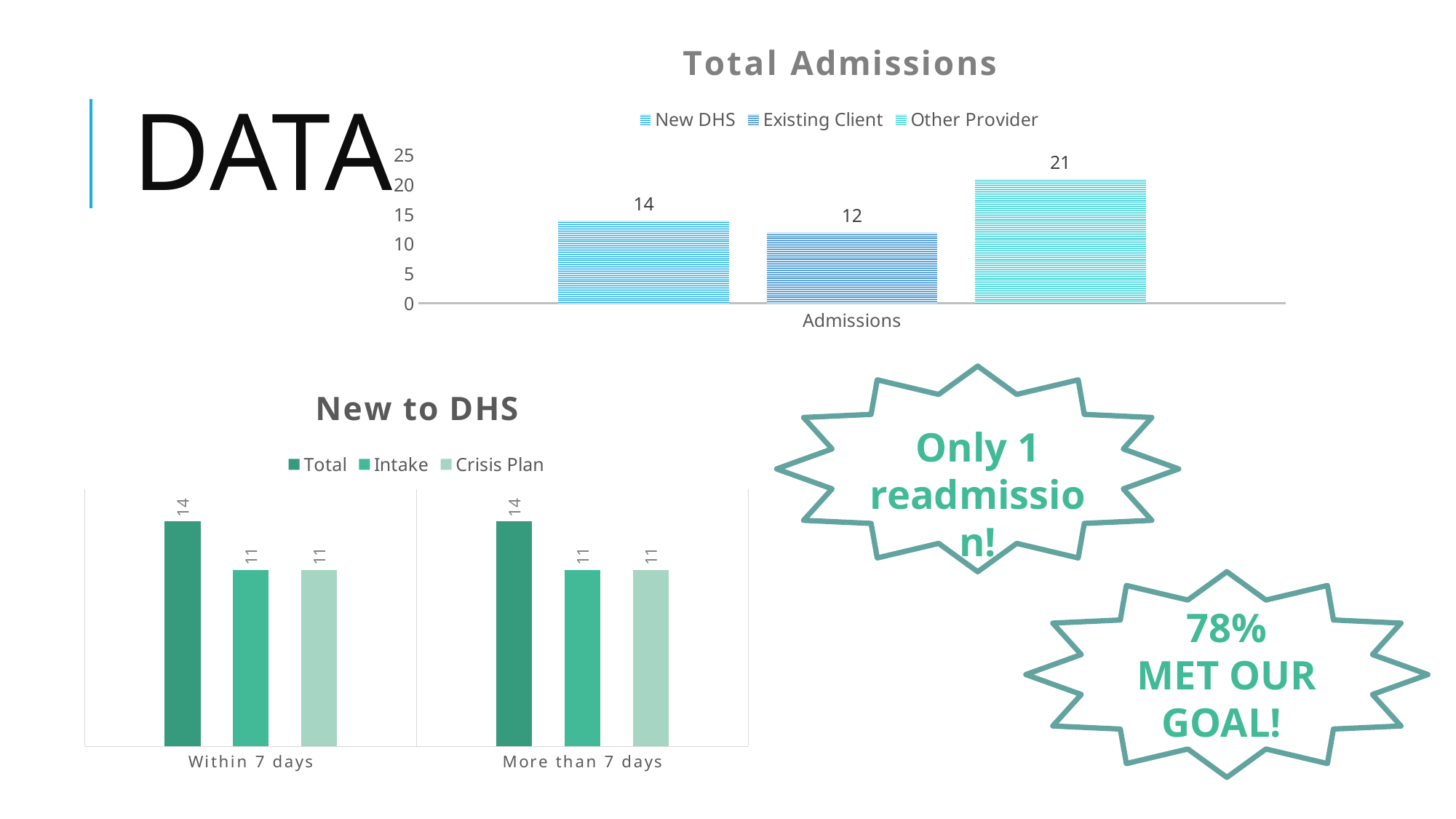
What kind of chart is the Total Admissions chart? Bar chart In the New to DHS chart, what is the difference between Total and Intake in the Within 7 days category? 3 In the Total Admissions chart, which series has the highest value? Other Provider In the Total Admissions chart, what is the value for Other Provider? 21 How many categories are shown on the x axis of the New to DHS chart? 2 How many series does the legend of the Total Admissions chart list? 3 In the New to DHS chart, what is the value for Total in the Within 7 days category? 14 In the Total Admissions chart, what is the difference between Other Provider and New DHS? 7 In the Total Admissions chart, which is larger, New DHS or Existing Client? New DHS In the Total Admissions chart, which series has the lowest value? Existing Client In the Total Admissions chart, what is the value for Existing Client? 12 In the New to DHS chart, what is the value for Crisis Plan in the More than 7 days category? 11